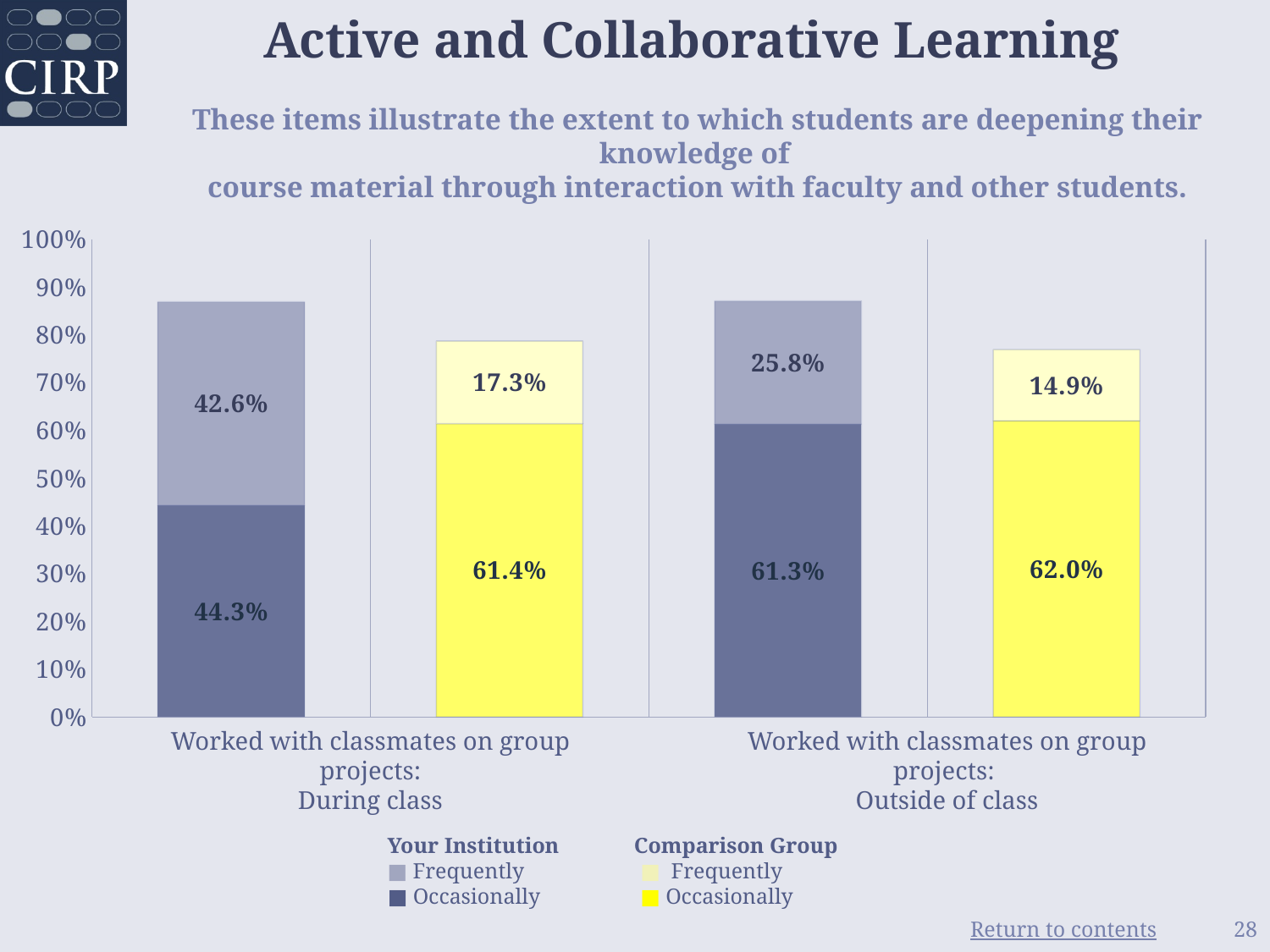
What colour represents the Comparison Group's Occasionally segment? Yellow What percentage of students at Your Institution reported frequently working with classmates on group projects during class? 42.6% Which of the four Frequently values shown on the chart is the lowest? 14.9% (Comparison Group, outside of class) For working with classmates on group projects outside of class, which group has the higher Frequently percentage, Your Institution or the Comparison Group? Your Institution What percentage of the Comparison Group reported frequently working with classmates on group projects during class? 17.3% What percentage of students at Your Institution reported occasionally working with classmates on group projects outside of class? 61.3% How many entries does the legend list? 4 What is the total percentage (Frequently plus Occasionally) for Your Institution's bar for working with classmates on group projects during class? 86.9% What percentage of the Comparison Group reported occasionally working with classmates on group projects outside of class? 62.0% What is the total percentage (Frequently plus Occasionally) for the Comparison Group's bar for working with classmates on group projects outside of class? 76.9% What is the difference between the Frequently percentages for Your Institution and the Comparison Group for working with classmates on group projects during class? 25.3% What type of chart is shown on the slide? Stacked bar chart